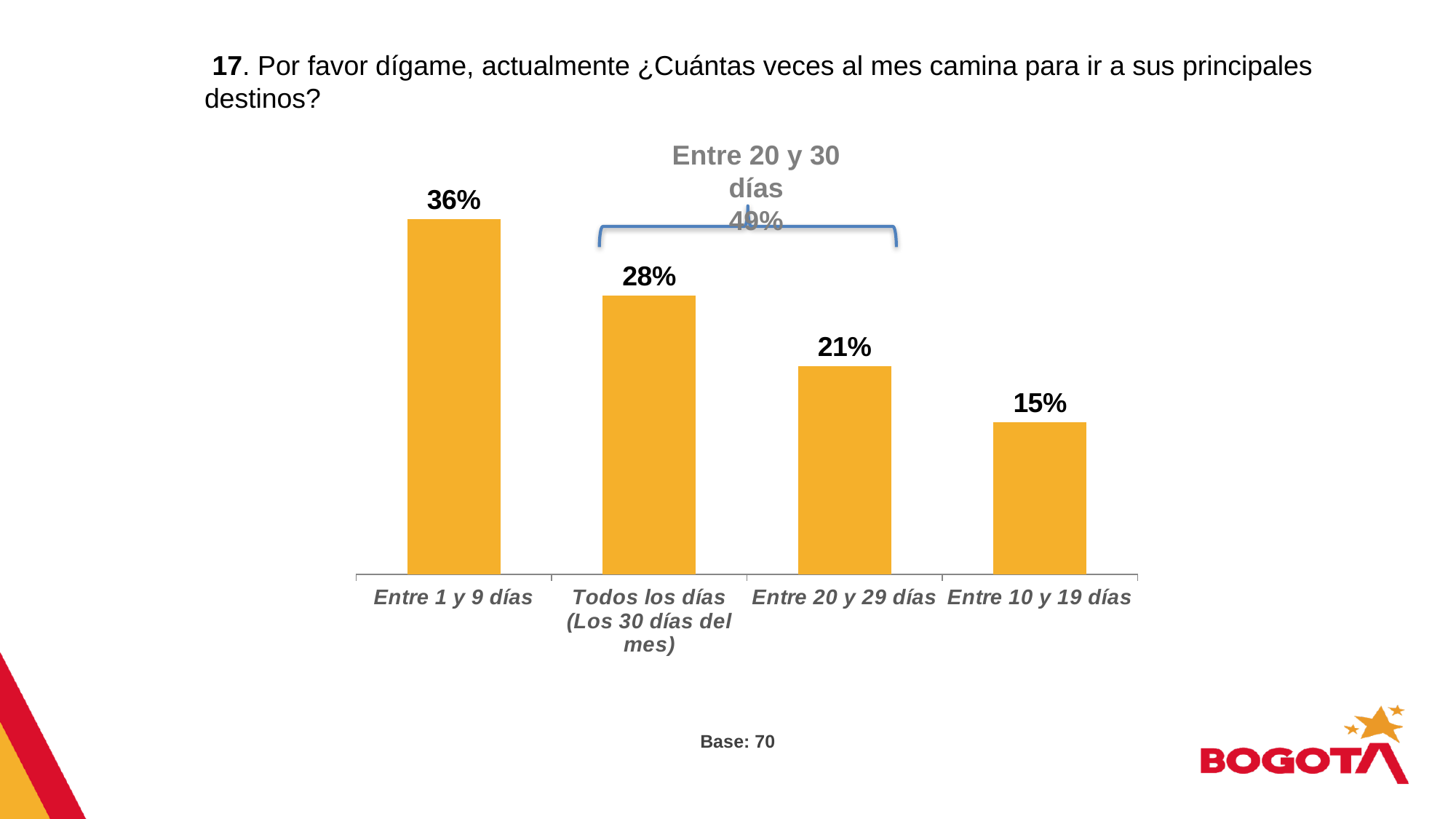
What is the value for 'Entre 1 y 9 días'? 36% What is the value for 'Entre 10 y 19 días'? 15% What is the difference between the values for 'Todos los días (Los 30 días del mes)' and 'Entre 20 y 29 días'? 7% Which category has the highest value? Entre 1 y 9 días Which category has the lowest value? Entre 10 y 19 días Which is larger, the value for 'Entre 20 y 29 días' or the value for 'Entre 10 y 19 días'? Entre 20 y 29 días What is the value for 'Todos los días (Los 30 días del mes)'? 28% How many categories are shown in the chart? 4 What kind of chart is shown on the slide? Bar chart What is the value for 'Entre 20 y 29 días'? 21% Do the values rise or fall from left to right along the x axis? Fall What is the difference between the values for 'Entre 1 y 9 días' and 'Entre 10 y 19 días'? 21%